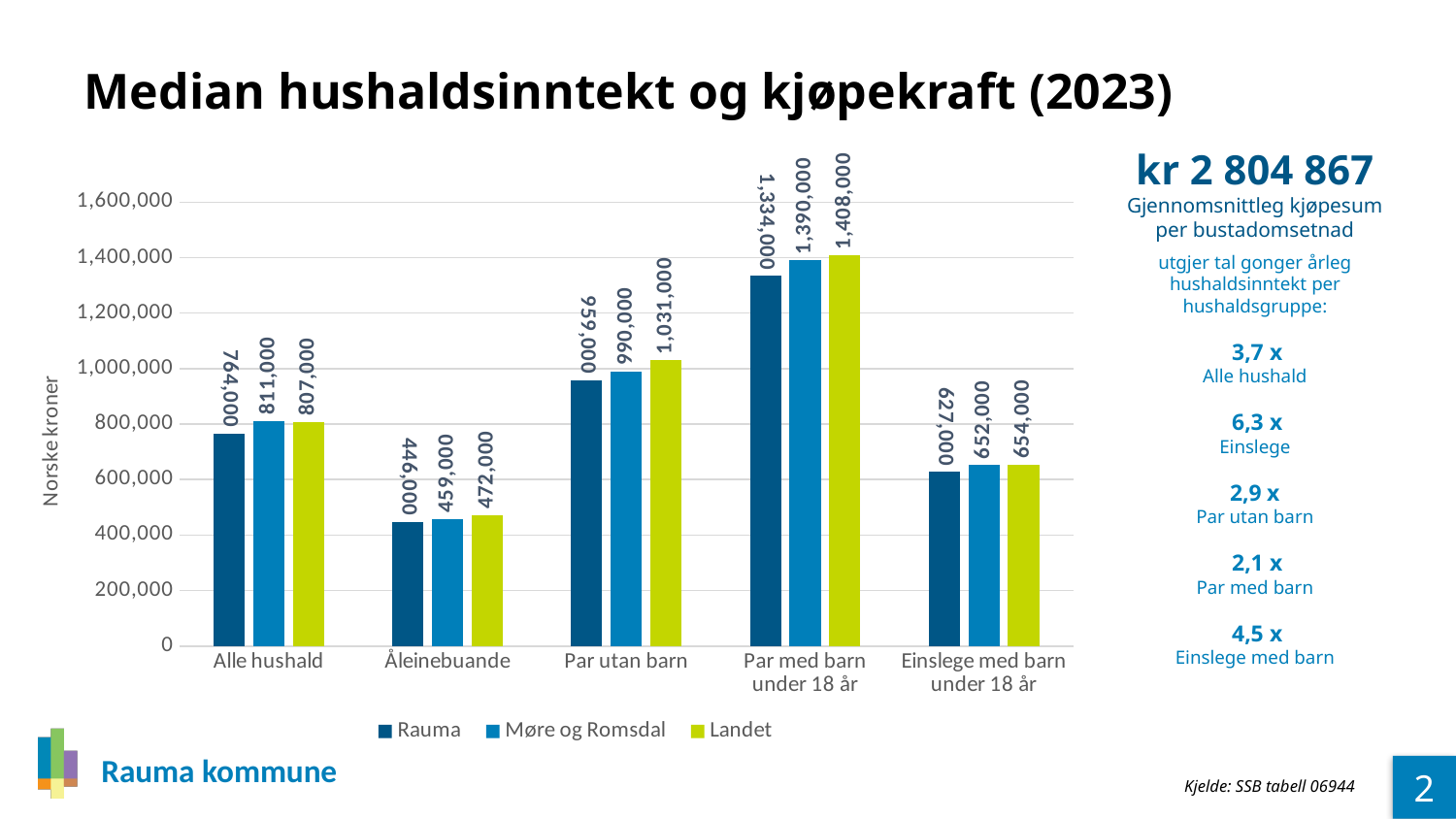
How many series does the legend list? 3 Which category has the highest value for Rauma? Par med barn under 18 år What is the value for Møre og Romsdal in the Åleinebuande category? 459,000 What is the difference between the Landet and Rauma values in the Par utan barn category? 72,000 What is the value for Rauma in the Alle hushald category? 764,000 In the Alle hushald category, which is larger: Møre og Romsdal or Landet? Møre og Romsdal What is the value for Landet in the Par med barn under 18 år category? 1,408,000 How many categories are shown on the x axis? 5 What kind of chart is shown on the slide? bar chart What is the title of the chart? Median hushaldsinntekt og kjøpekraft (2023) Which category has the lowest value for Landet? Åleinebuande Is the value for Rauma in the Einslege med barn under 18 år category greater or less than 800,000? less